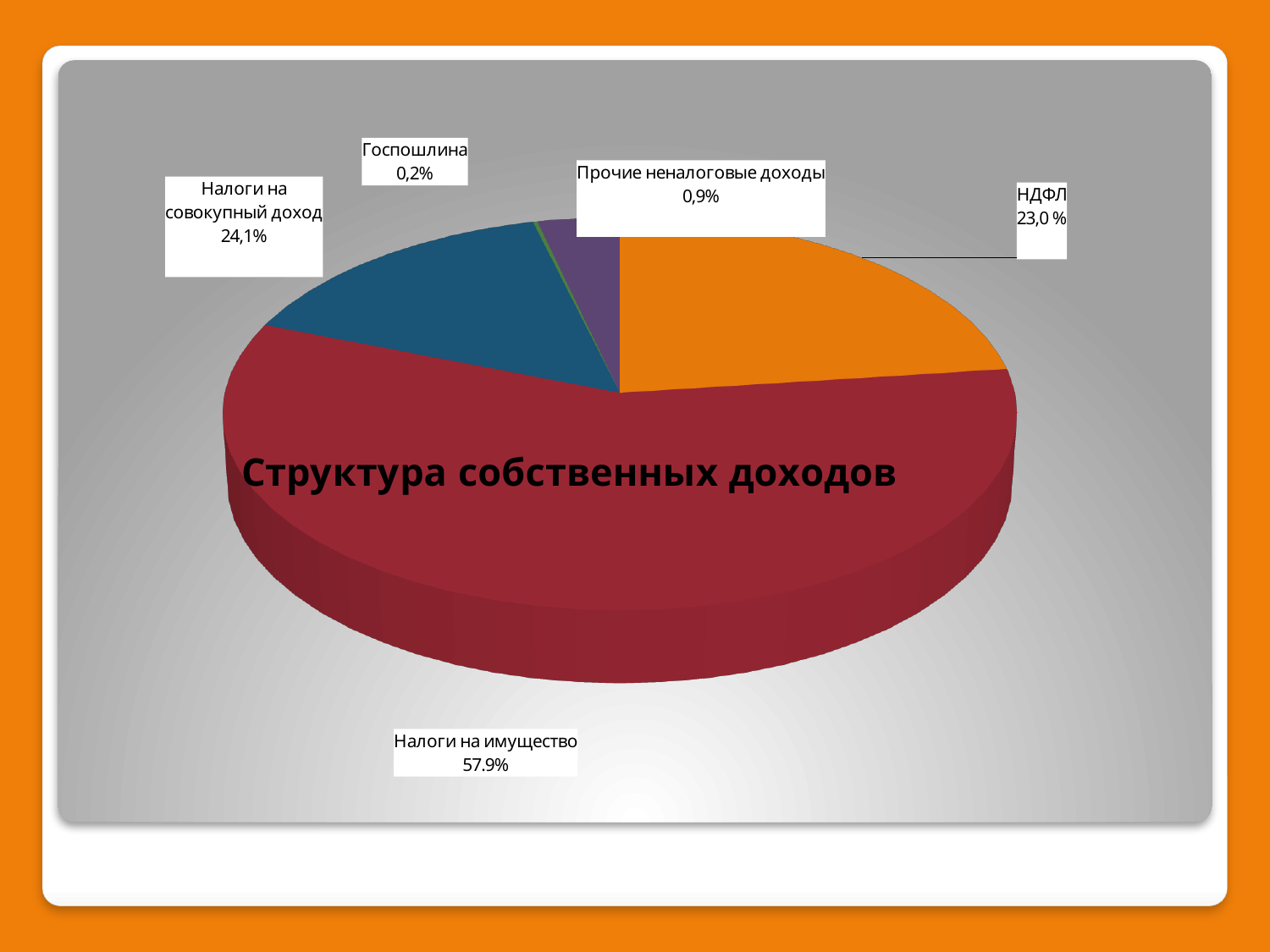
What share does Госпошлина have in the pie chart? 0,2% What is the title of the chart? Структура собственных доходов Which category has the largest share of the pie? Налоги на имущество What share does Налоги на имущество have in the pie chart? 57.9% How many slices does the pie chart have? 5 What kind of chart is shown on the slide? Pie chart What share does Налоги на совокупный доход have in the pie chart? 24,1% Which category has the smallest share of the pie? Госпошлина What share does НДФЛ have in the pie chart? 23,0 % What share does Прочие неналоговые доходы have in the pie chart? 0,9%